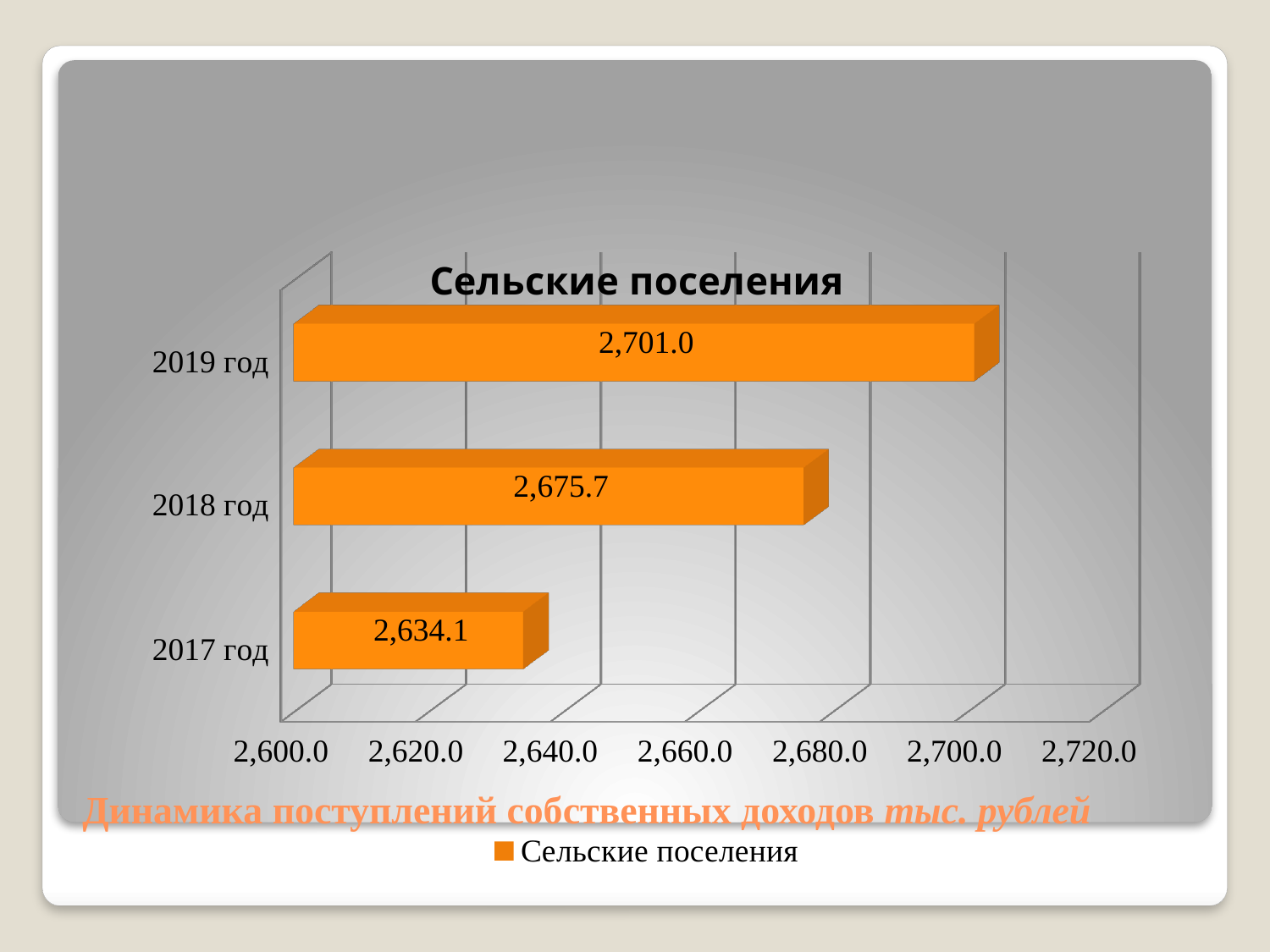
What is the value for 2019 год? 2,701.0 Which is larger, the value for 2018 год or the value for 2017 год? 2018 год What is the difference between the values for 2019 год and 2018 год? 25.3 How many series does the legend list? 1 What kind of chart is shown on the slide? bar chart What is the difference between the values for 2018 год and 2017 год? 41.6 Do the values rise or fall from 2017 год to 2019 год? rise How many years are shown in the chart? 3 What is the value for 2018 год? 2,675.7 Which year has the lowest value? 2017 год Which year has the highest value? 2019 год What is the value for 2017 год? 2,634.1